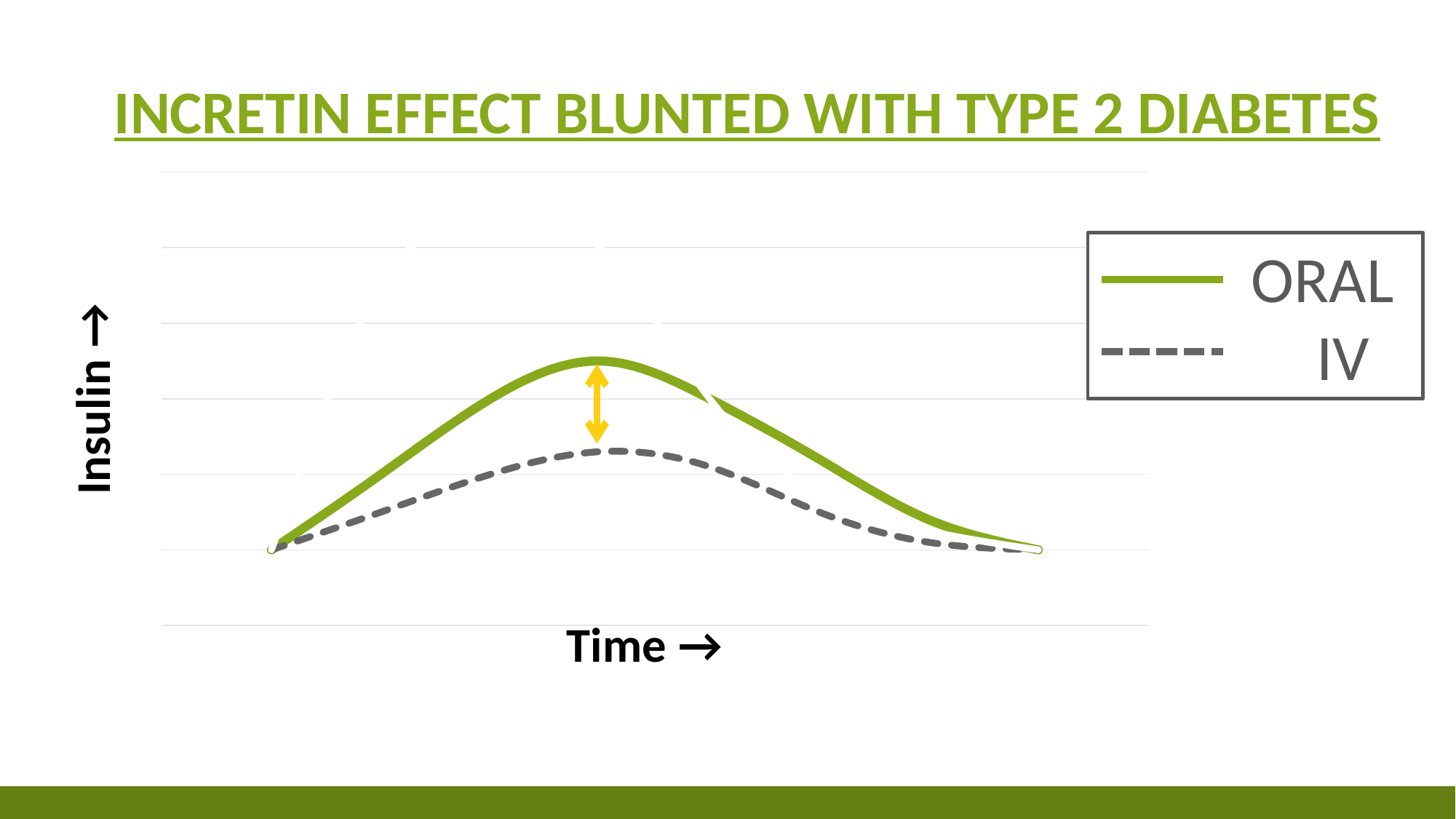
How does the ORAL series change along the time axis? rises to a peak, then falls Which series has the lower peak insulin level? IV How does the IV series change along the time axis? rises to a peak, then falls Which series has the highest insulin level at its peak? ORAL Which series reaches the higher peak, ORAL or IV? ORAL What kind of chart is shown on the slide? line chart What is the title of the chart? INCRETIN EFFECT BLUNTED WITH TYPE 2 DIABETES How many series does the legend list? 2 Which series is drawn with a dashed line? IV Is the ORAL line above or below the IV line at the peak? above